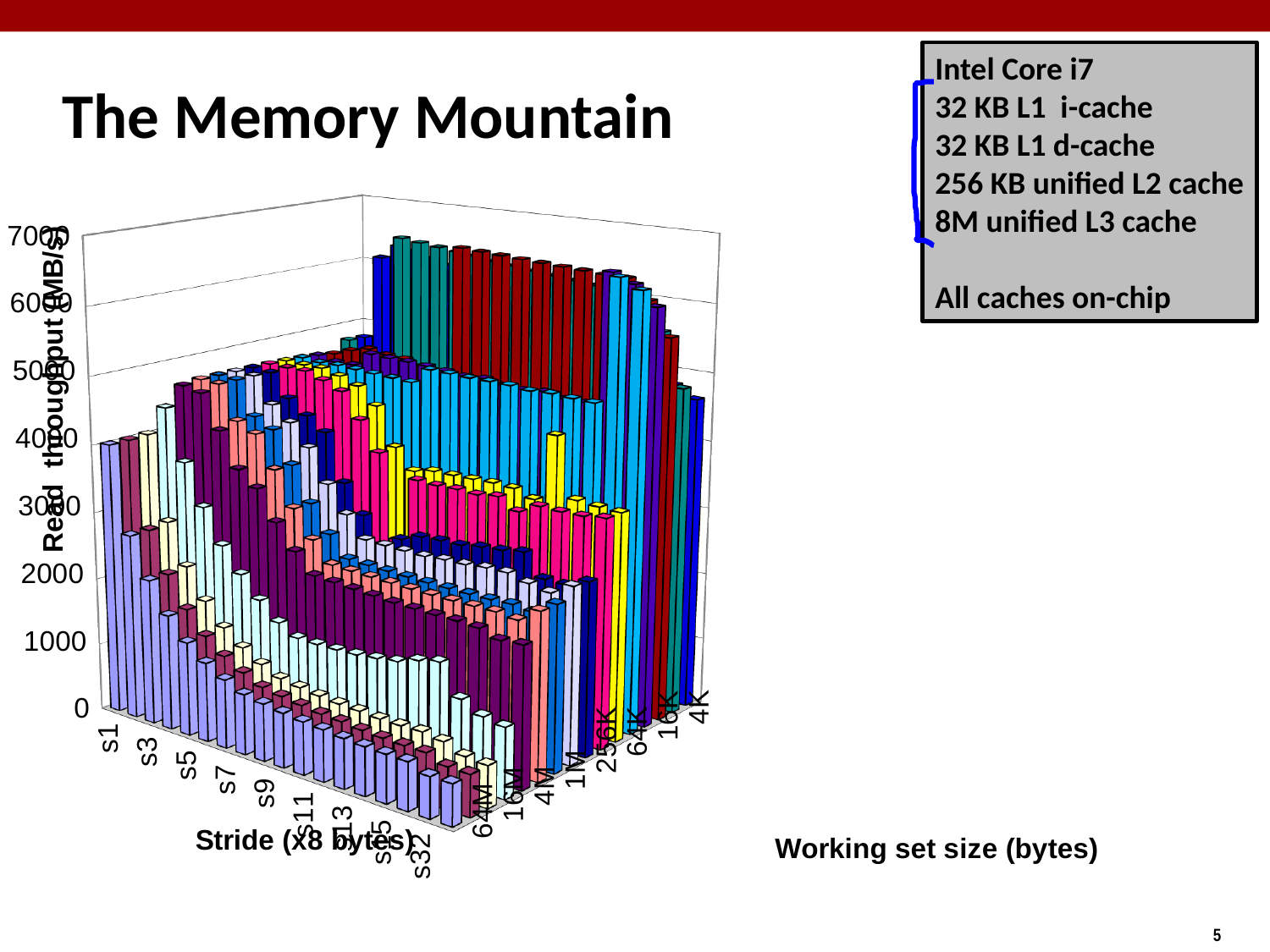
Is the read throughput for stride s32 at a working set size of 64M greater or less than 1000 MB/s? less What is the label of the vertical axis of the chart? Read throughput (MB/s) What is the maximum value shown on the vertical axis of the chart? 7000 Is the highest read throughput for stride s1 at a working set size of 16K greater or less than 6000 MB/s? less What is the title of the slide's chart? The Memory Mountain What kind of chart is shown on the slide? 3D bar chart How many working set size labels are printed along the working set size axis of the chart? 8 For stride s1, is the read throughput at a working set size of 16K larger or smaller than at 64M? larger For a working set size of 64M, does read throughput rise or fall as the stride increases from s1 to s32? fall How many stride labels are printed along the stride axis of the chart? 9